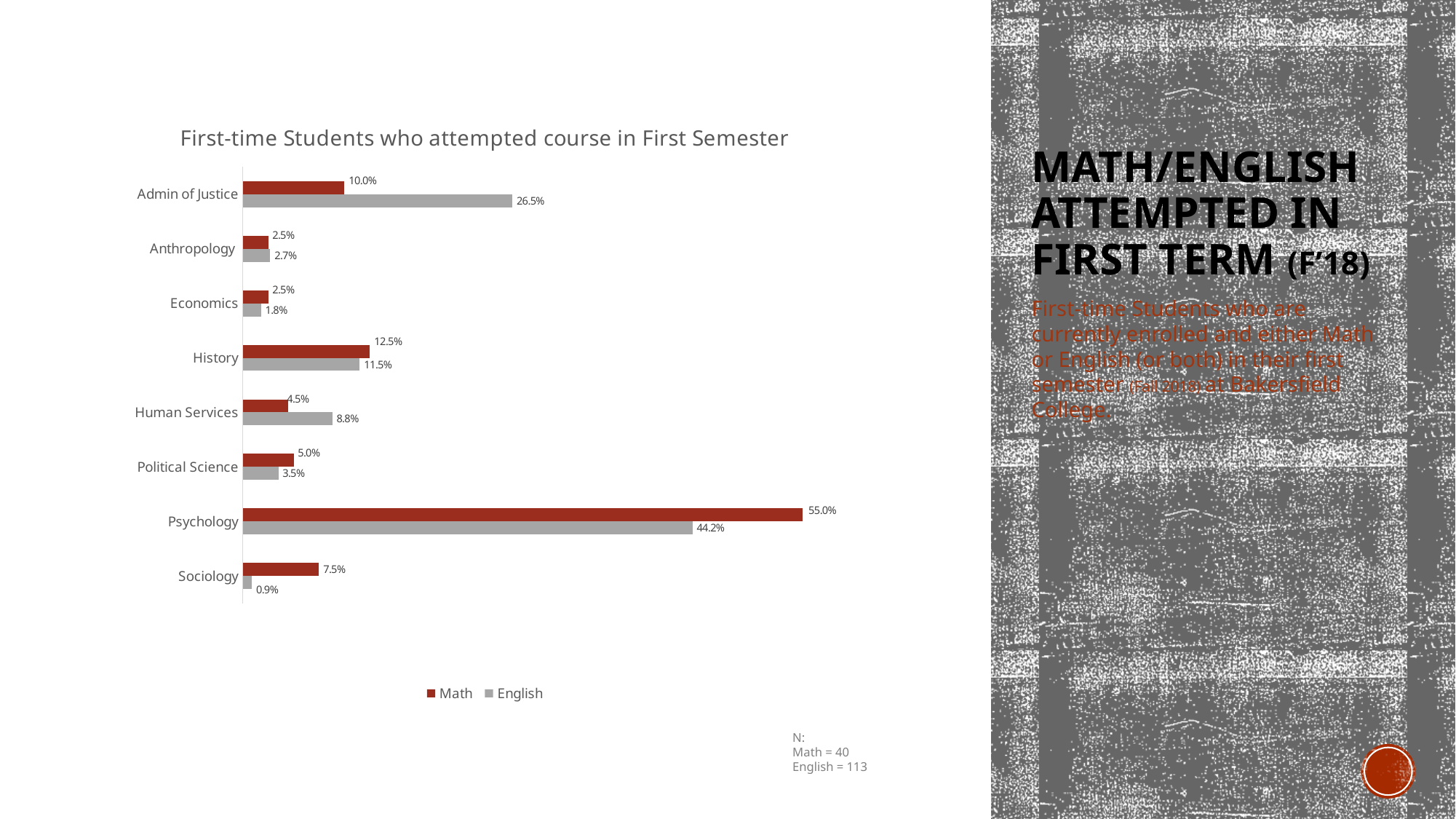
Which category has the lowest English value? Sociology What is the title of the chart? First-time Students who attempted course in First Semester Which category has the highest Math value? Psychology How many categories are shown on the chart? 8 How many series does the legend list? 2 What is the Math value for Admin of Justice? 10.0% What is the English value for Sociology? 0.9% What is the difference between the Math and English values for Psychology? 10.8% What kind of chart is shown on the slide? Bar chart Which is larger for Human Services, the Math value or the English value? English What is the English value for Psychology? 44.2% What is the difference between the Math and English values for Admin of Justice? 16.5%